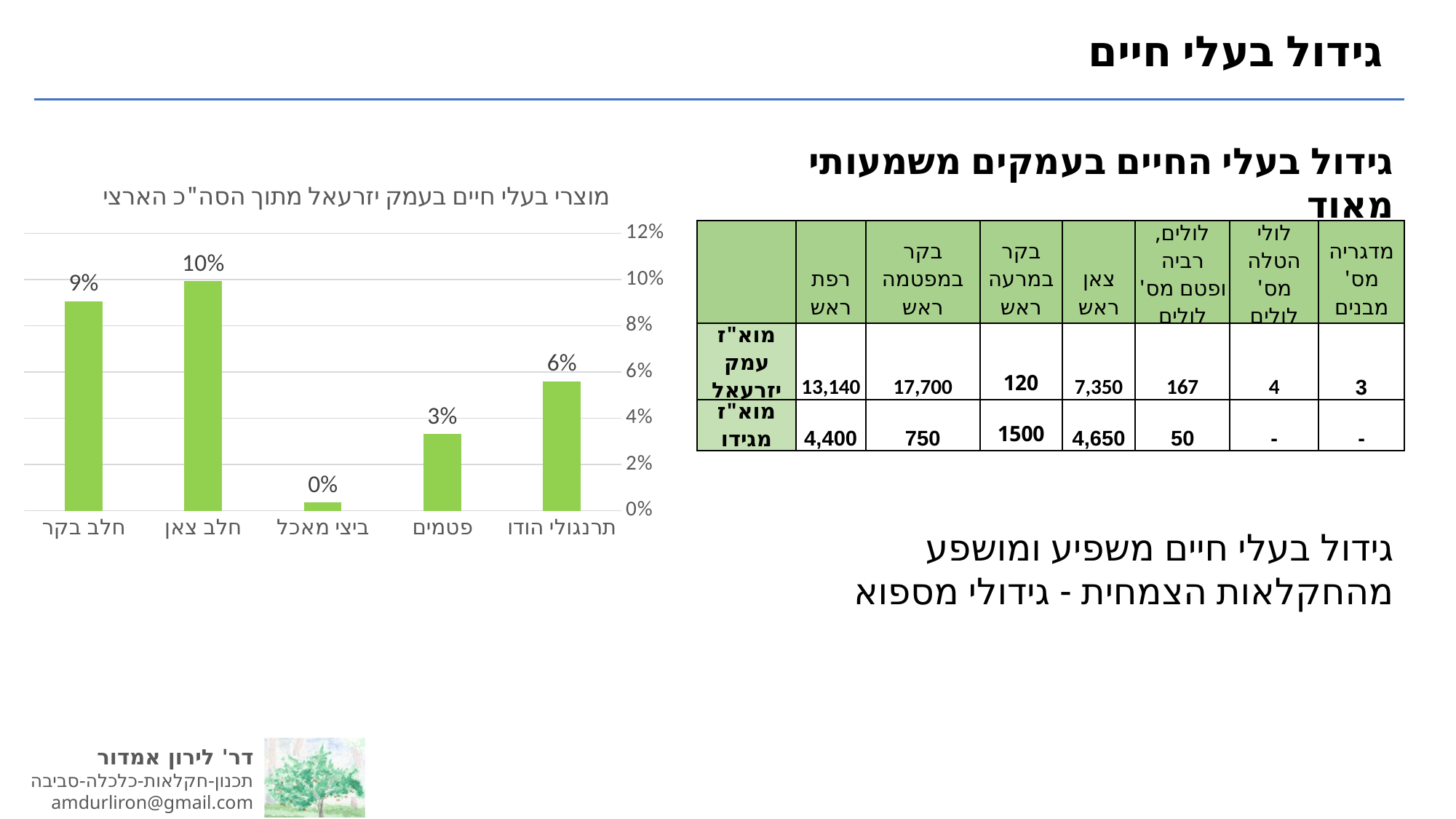
How many categories are shown in the chart? 5 Which category has the highest value in the chart? חלב צאן What is the value for חלב צאן in the chart? 10% What kind of chart is shown on the slide? Bar chart What is the value for ביצי מאכל in the chart? 0% What is the value for פטמים in the chart? 3% What is the title of the chart? מוצרי בעלי חיים בעמק יזרעאל מתוך הסה"כ הארצי Which is larger, the value for תרנגולי הודו or the value for פטמים? תרנגולי הודו What is the difference between the values for חלב צאן and פטמים? 7% Which category has the lowest value in the chart? ביצי מאכל What is the value for תרנגולי הודו in the chart? 6% What is the value for חלב בקר in the chart? 9%